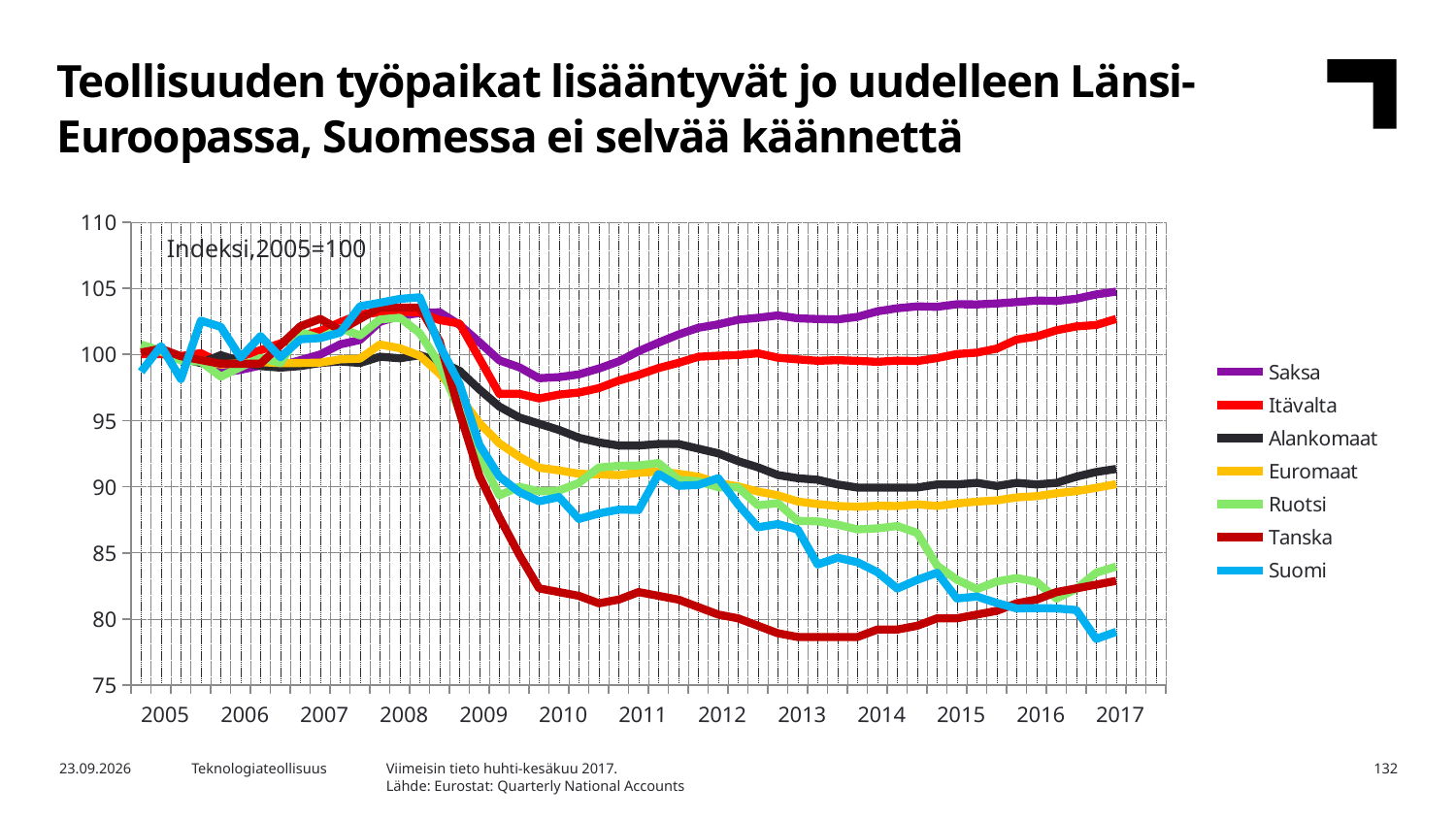
What index base is stated in the chart? Indeksi, 2005=100 Is the value for Euromaat in 2014 greater or less than 95? less Which series has the highest value at the end of the chart in 2017? Saksa Is the value for Tanska in 2013 greater or less than 85? less In 2015, which is larger: the value for Saksa or the value for Tanska? Saksa What kind of chart is shown on the slide? line chart Is the value for Suomi in 2017 greater or less than 85? less How many series does the legend list? 7 Does the Tanska line rise or fall between 2008 and 2010? fall Which series are listed in the legend? Saksa, Itävalta, Alankomaat, Euromaat, Ruotsi, Tanska, Suomi Which series has the lowest value at the end of the chart in 2017? Suomi